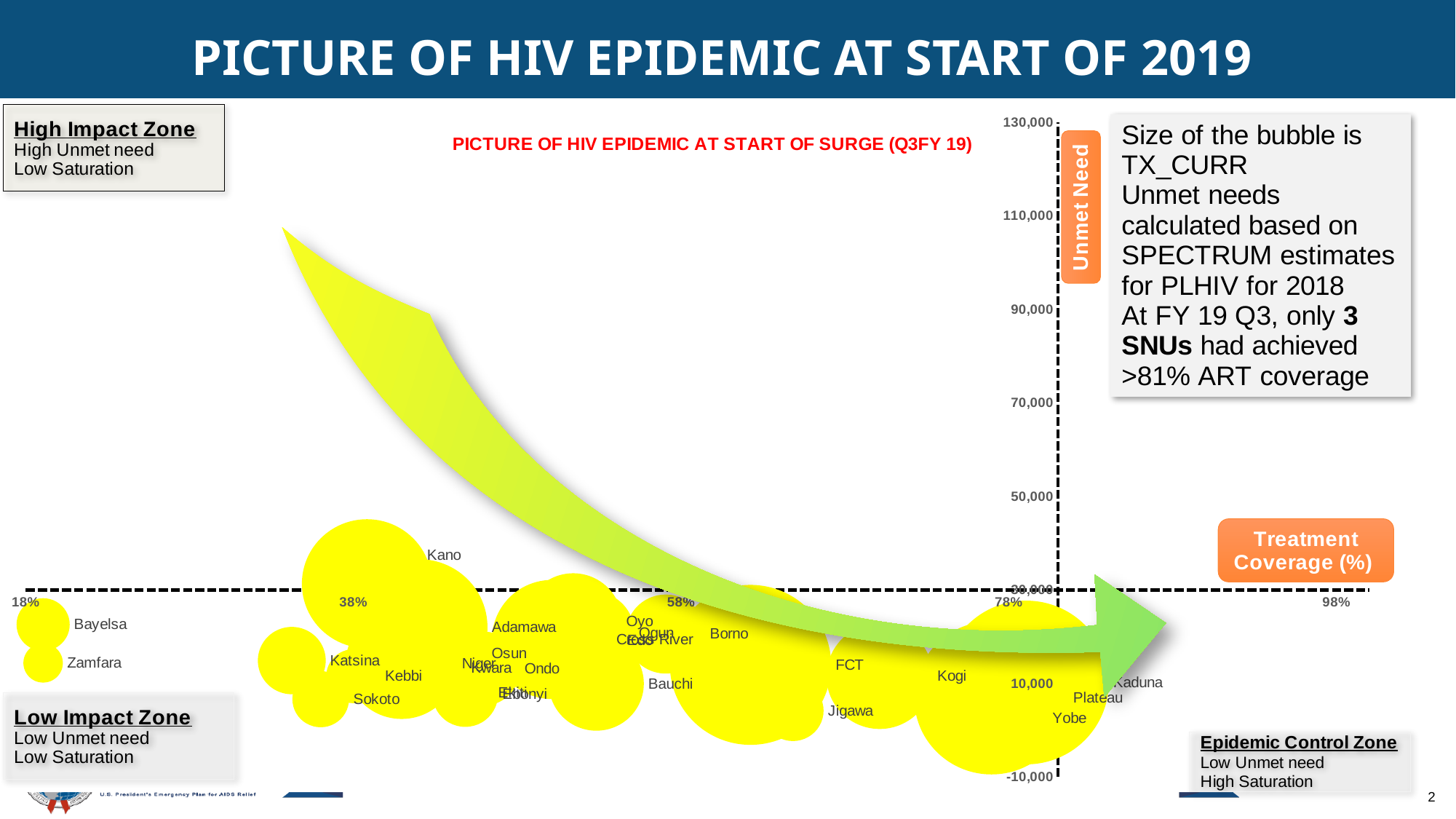
Is the treatment coverage for Kano greater or less than 58%? less Is the unmet need for Bayelsa greater or less than 30,000? less Which has the higher treatment coverage, Kano or Kogi? Kogi What does the vertical axis of the chart represent? Unmet Need Which has the higher treatment coverage, Bayelsa or Kaduna? Kaduna Is the treatment coverage for Kaduna greater or less than 78%? greater What kind of chart is shown on the slide? bubble chart What is the title of the chart? PICTURE OF HIV EPIDEMIC AT START OF SURGE (Q3FY 19)